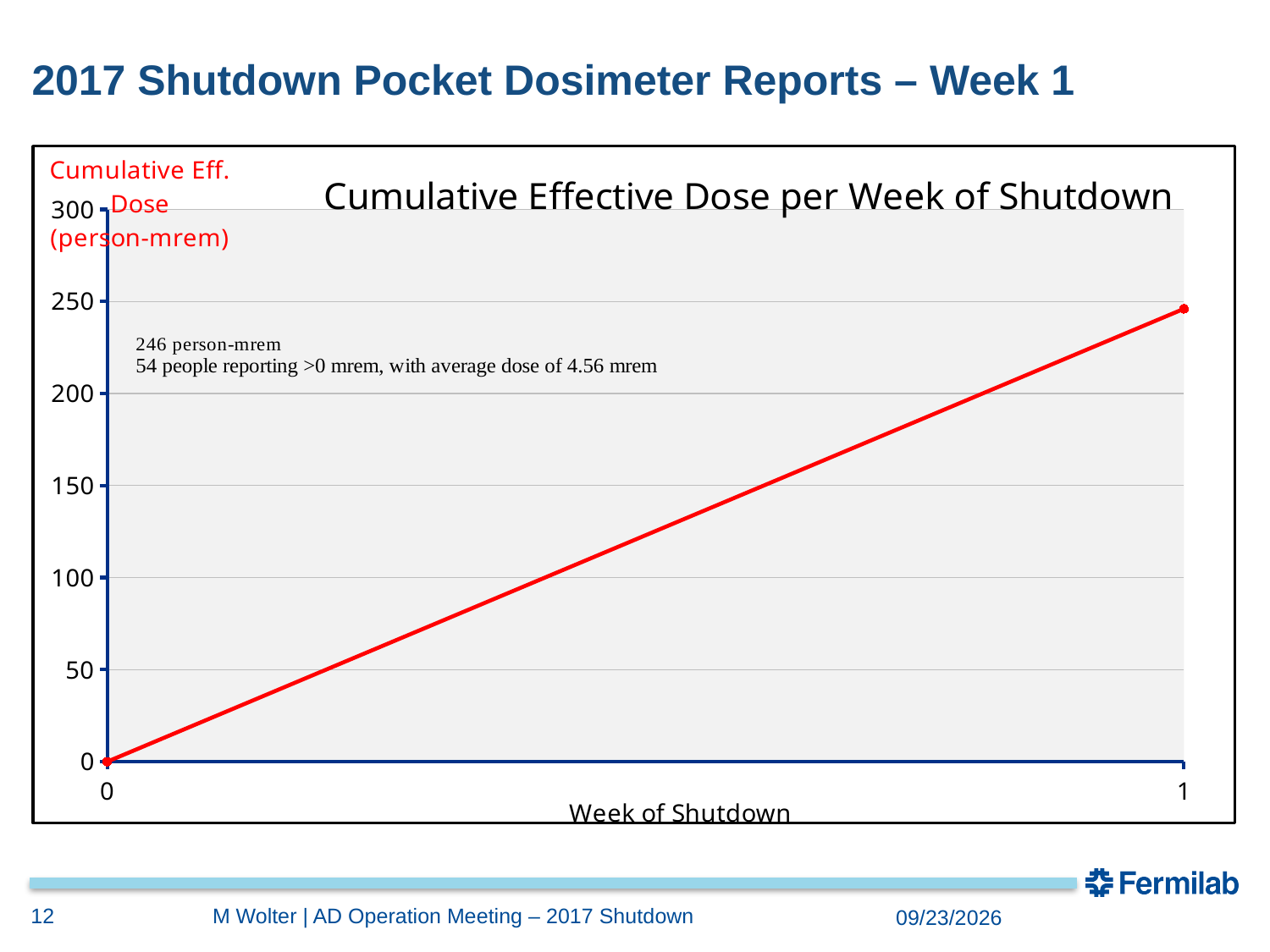
What is the label of the x axis? Week of Shutdown Does the cumulative effective dose rise or fall from week 0 to week 1? rise What type of chart is shown on the slide? line chart Is the cumulative effective dose at week 1 greater or less than 250? less Is the cumulative effective dose at week 1 greater or less than 200? greater How many people reported a dose greater than 0 mrem according to the chart annotation? 54 What is the title of the chart? Cumulative Effective Dose per Week of Shutdown What is the cumulative effective dose at week 1 of the shutdown? 246 person-mrem What is the cumulative effective dose at week 0 of the shutdown? 0 How many data points are plotted on the chart? 2 By how much does the cumulative effective dose increase from week 0 to week 1? 246 person-mrem Which week has the higher cumulative effective dose, week 0 or week 1? week 1